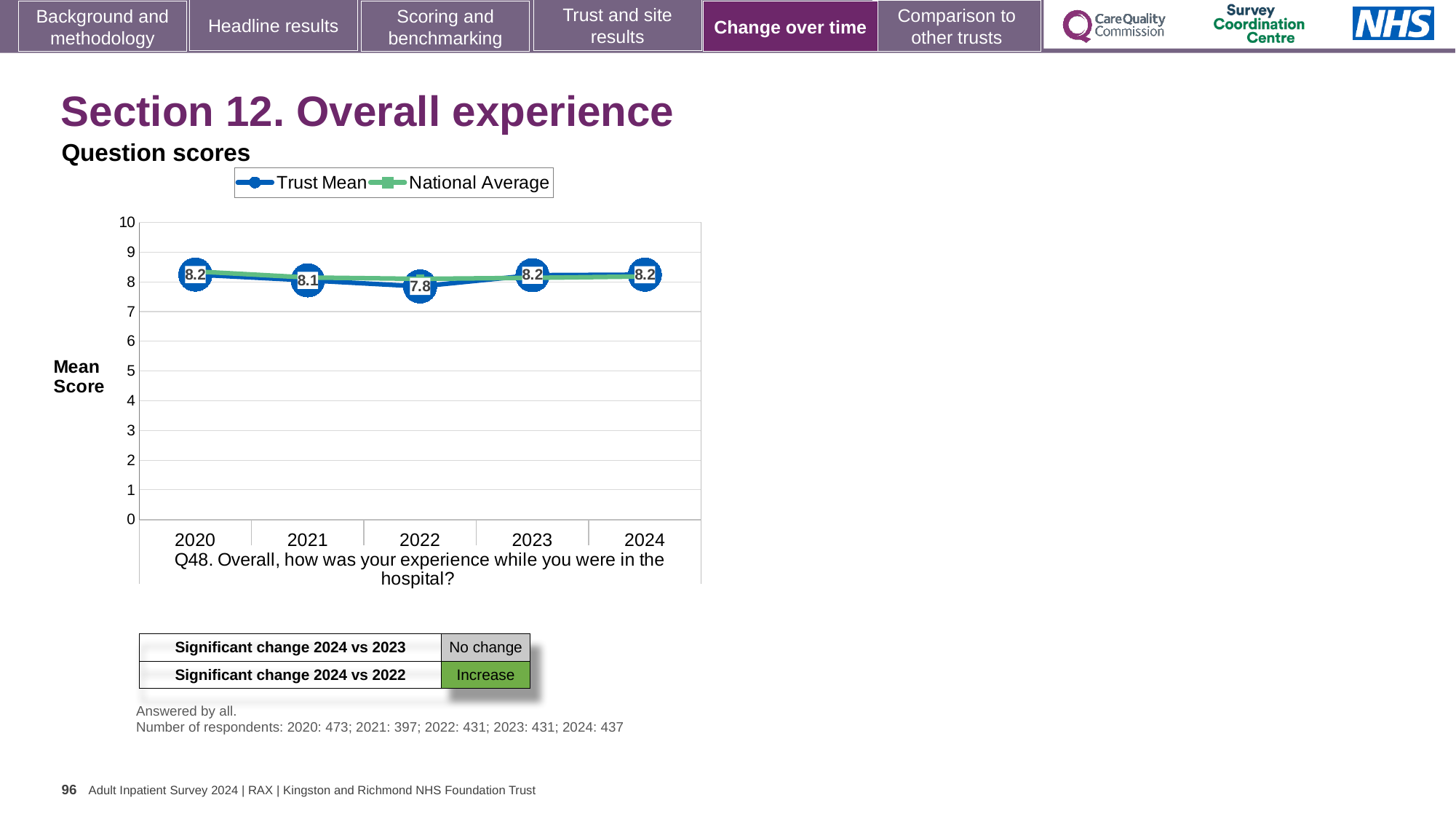
Is the National Average value for 2022 greater or less than 7? greater What is the difference between the Trust Mean scores for 2023 and 2022? 0.4 In which year is the Trust Mean score lowest? 2022 What is the Trust Mean score for 2022? 7.8 How many series does the legend list? 2 How many years are plotted on the x axis? 5 What is the Trust Mean score for 2021? 8.1 What kind of chart is shown on the slide? Line chart What is the label on the y axis of the chart? Mean Score Which year has the larger Trust Mean score, 2021 or 2022? 2021 Does the Trust Mean score rise or fall from 2022 to 2023? Rise What is the Trust Mean score for 2024? 8.2